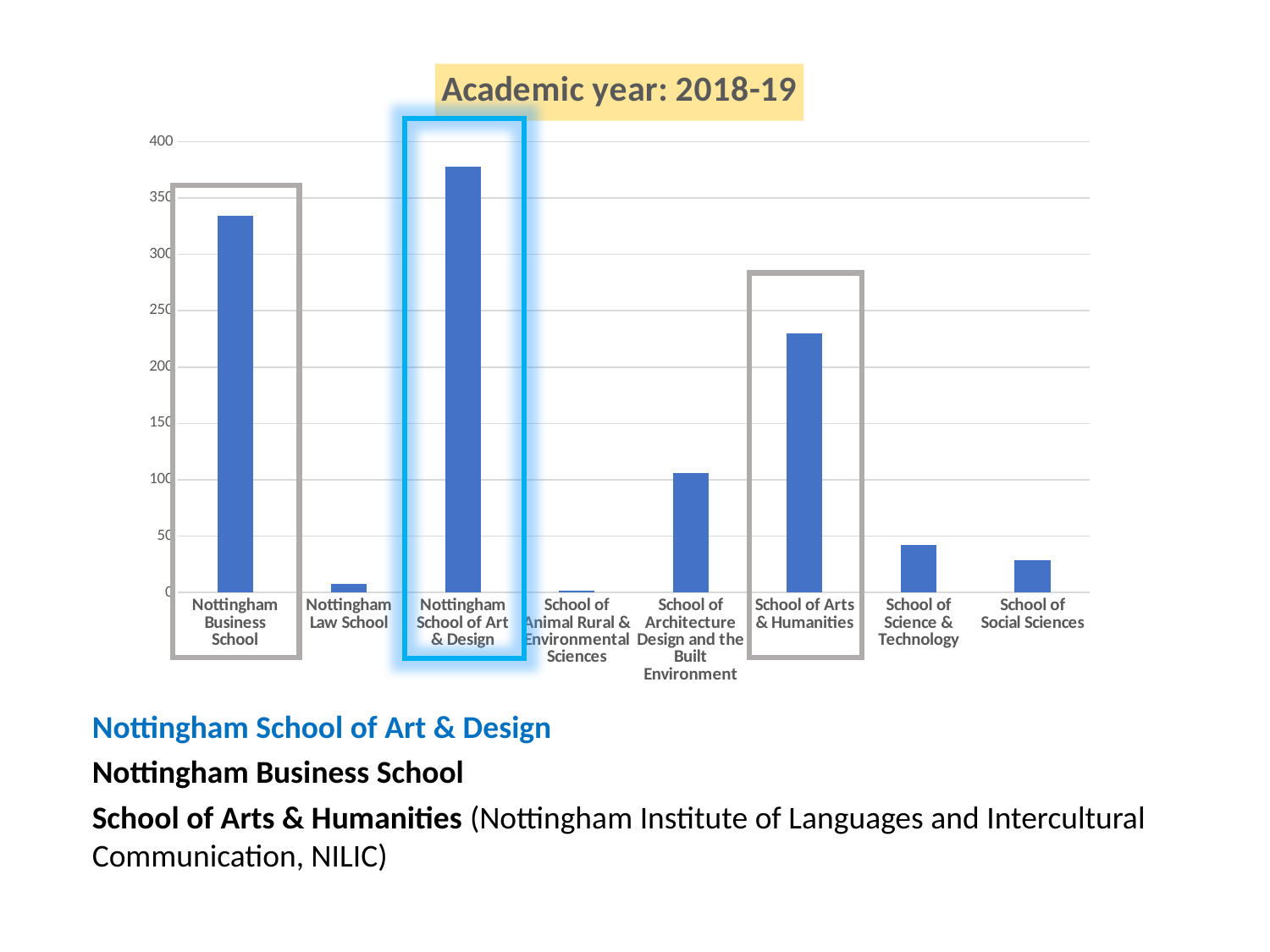
How many schools are shown along the x axis of the chart? 8 Is the value for Nottingham Business School greater or less than 300? greater Which school's bar is highlighted with a blue outline on the chart? Nottingham School of Art & Design Which school has the highest bar in the chart? Nottingham School of Art & Design What kind of chart is shown on the slide? bar chart Is the value for School of Arts & Humanities greater or less than 250? less Is the value for Nottingham School of Art & Design greater or less than 350? greater What is the title of the chart? Academic year: 2018-19 Which is larger: the value for Nottingham Business School or the value for School of Arts & Humanities? Nottingham Business School Which is larger: the value for School of Science & Technology or the value for School of Social Sciences? School of Science & Technology Which school has the lowest bar in the chart? School of Animal Rural & Environmental Sciences